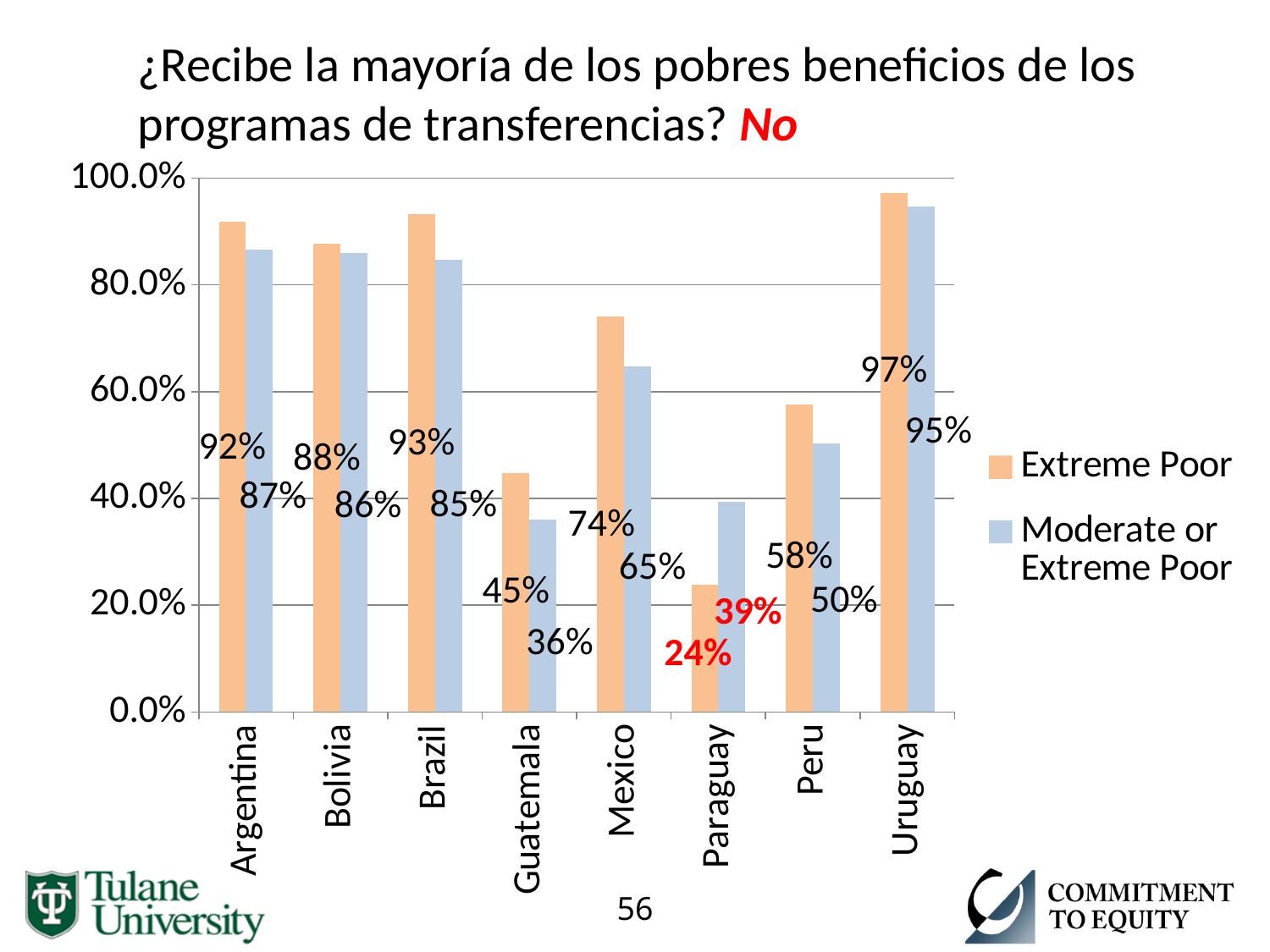
Which country has the highest Extreme Poor value? Uruguay What kind of chart is shown on the slide? Bar chart For Paraguay, which is larger: the Extreme Poor value or the Moderate or Extreme Poor value? Moderate or Extreme Poor What is the Moderate or Extreme Poor value for Guatemala? 36% How many series does the legend list? 2 How many countries are shown on the x axis? 8 Is the Extreme Poor value for Peru greater or less than 40.0%? greater Which country has the lowest Moderate or Extreme Poor value? Guatemala What is the Extreme Poor value for Brazil? 93% What is the difference between the Extreme Poor and Moderate or Extreme Poor values for Mexico? 9% What is the Extreme Poor value for Paraguay? 24% Which series is shown in orange in the legend? Extreme Poor